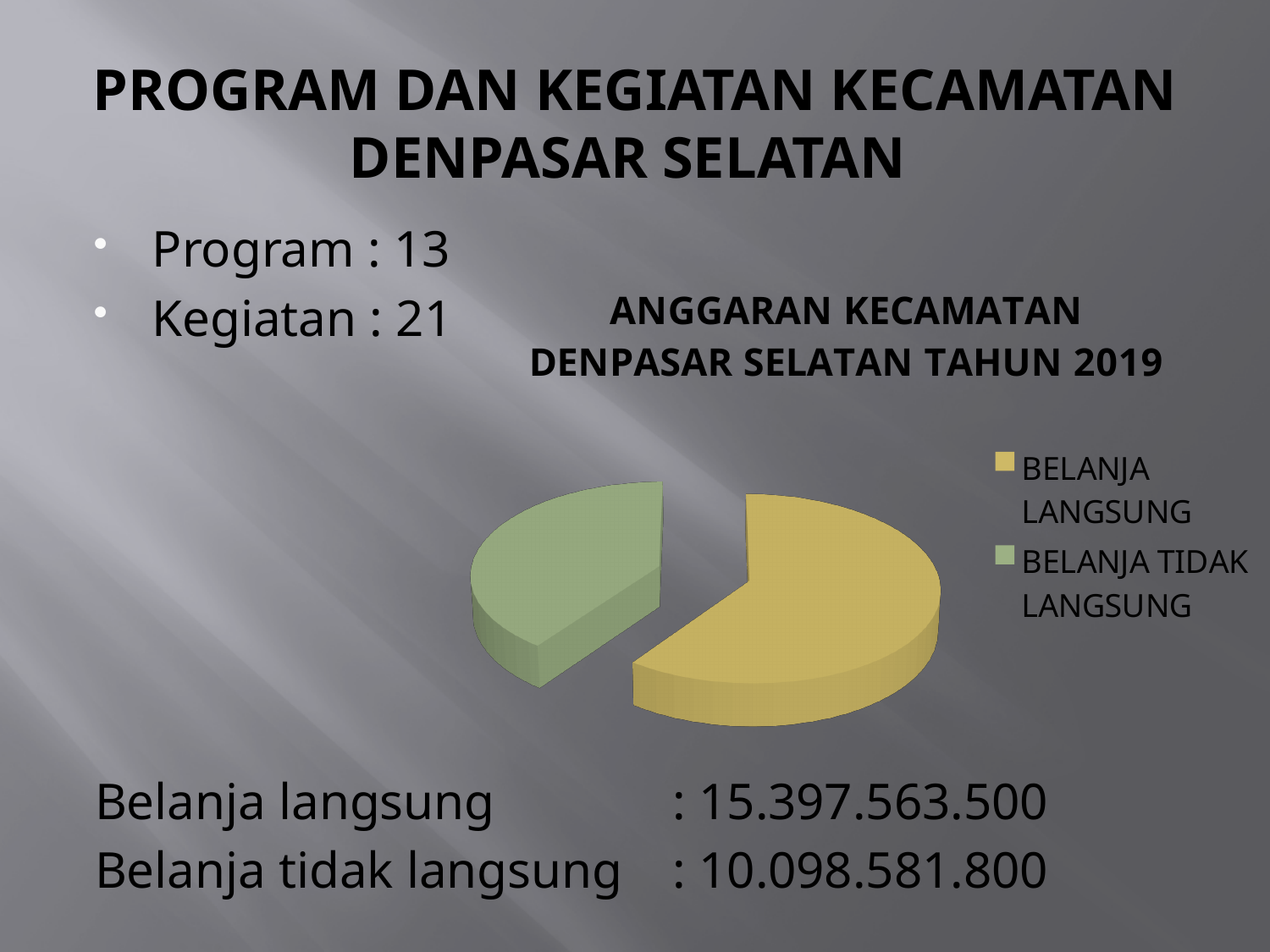
What is the value for Belanja tidak langsung shown on the slide? 10.098.581.800 How many entries does the chart legend list? 2 Which is larger, Belanja Langsung or Belanja Tidak Langsung? Belanja Langsung Which category has the largest slice of the pie chart? BELANJA LANGSUNG What is the total of Belanja langsung and Belanja tidak langsung? 25.496.145.300 What is the difference between Belanja langsung and Belanja tidak langsung? 5.298.981.700 How many slices does the pie chart have? 2 Which category has the smallest slice of the pie chart? BELANJA TIDAK LANGSUNG What is the value for Belanja langsung shown on the slide? 15.397.563.500 What is the title of the chart? ANGGARAN KECAMATAN DENPASAR SELATAN TAHUN 2019 What kind of chart is shown on the slide? Pie chart What colour is the slice for BELANJA TIDAK LANGSUNG? Green